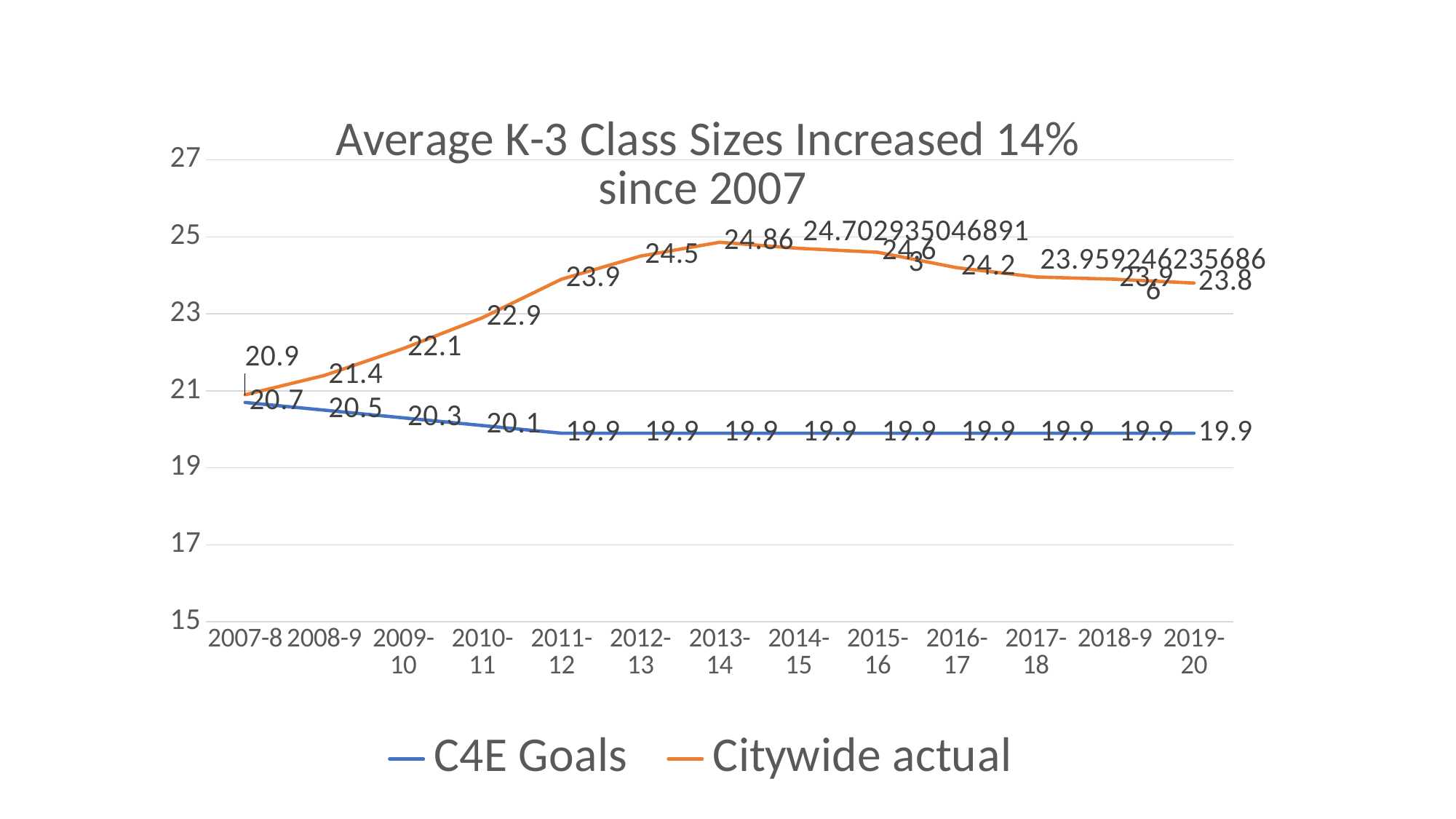
What is the difference between the Citywide actual and C4E Goals values in 2019-20? 3.9 Which series has the larger value in 2012-13, C4E Goals or Citywide actual? Citywide actual What is the C4E Goals value for 2019-20? 19.9 What is the Citywide actual value for 2007-8? 20.9 Do the C4E Goals values rise or fall from 2007-8 to 2011-12? fall In which school year is the Citywide actual value lowest? 2007-8 How many series does the legend list? 2 What is the Citywide actual value for 2010-11? 22.9 What is the title of the chart? Average K-3 Class Sizes Increased 14% since 2007 In which school year is the Citywide actual value highest? 2013-14 How many school years are plotted along the x axis? 13 What type of chart is shown on the slide? line chart